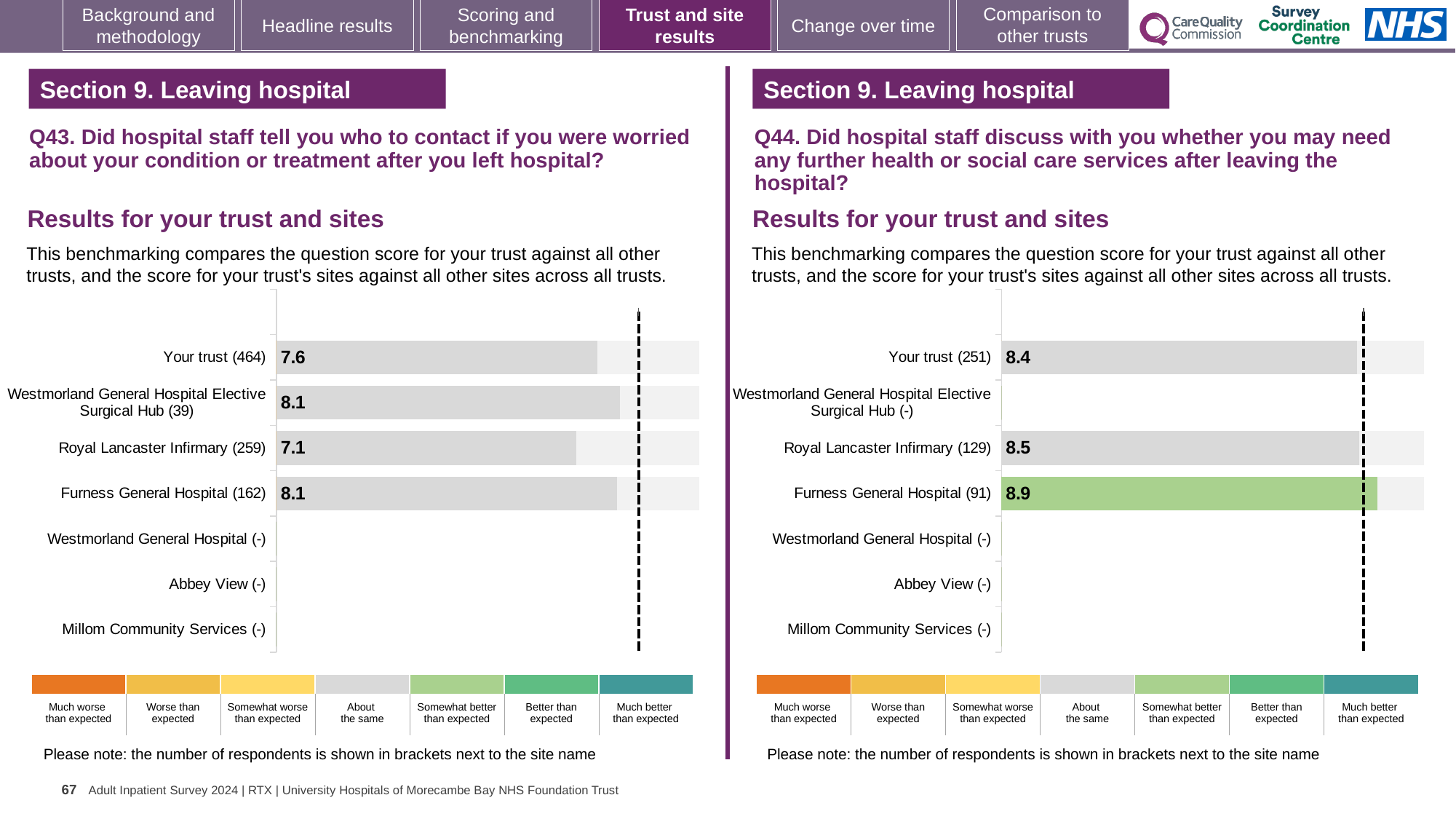
On the Q43 chart (left), what is the difference between the scores for Furness General Hospital and Royal Lancaster Infirmary? 1.0 On the Q44 chart (right), which site's bar is coloured green (somewhat better than expected)? Furness General Hospital On the Q44 chart (right), what is the difference between the scores for Furness General Hospital and Your trust? 0.5 On the Q44 chart (right), what is the score for Furness General Hospital? 8.9 On the Q43 chart (left), which site has the lowest score? Royal Lancaster Infirmary On the Q44 chart (right), which site has the highest score? Furness General Hospital On the Q44 chart (right), which is larger: the score for Royal Lancaster Infirmary or the score for Your trust? Royal Lancaster Infirmary On the Q43 chart (left), what is the score for Royal Lancaster Infirmary? 7.1 What kind of chart is used on the Q43 chart (left)? Bar chart On the Q43 chart (left), what is the score for Your trust? 7.6 On the Q44 chart (right), what is the score for Your trust? 8.4 On the Q43 chart (left), how many respondents are shown for Westmorland General Hospital Elective Surgical Hub? 39